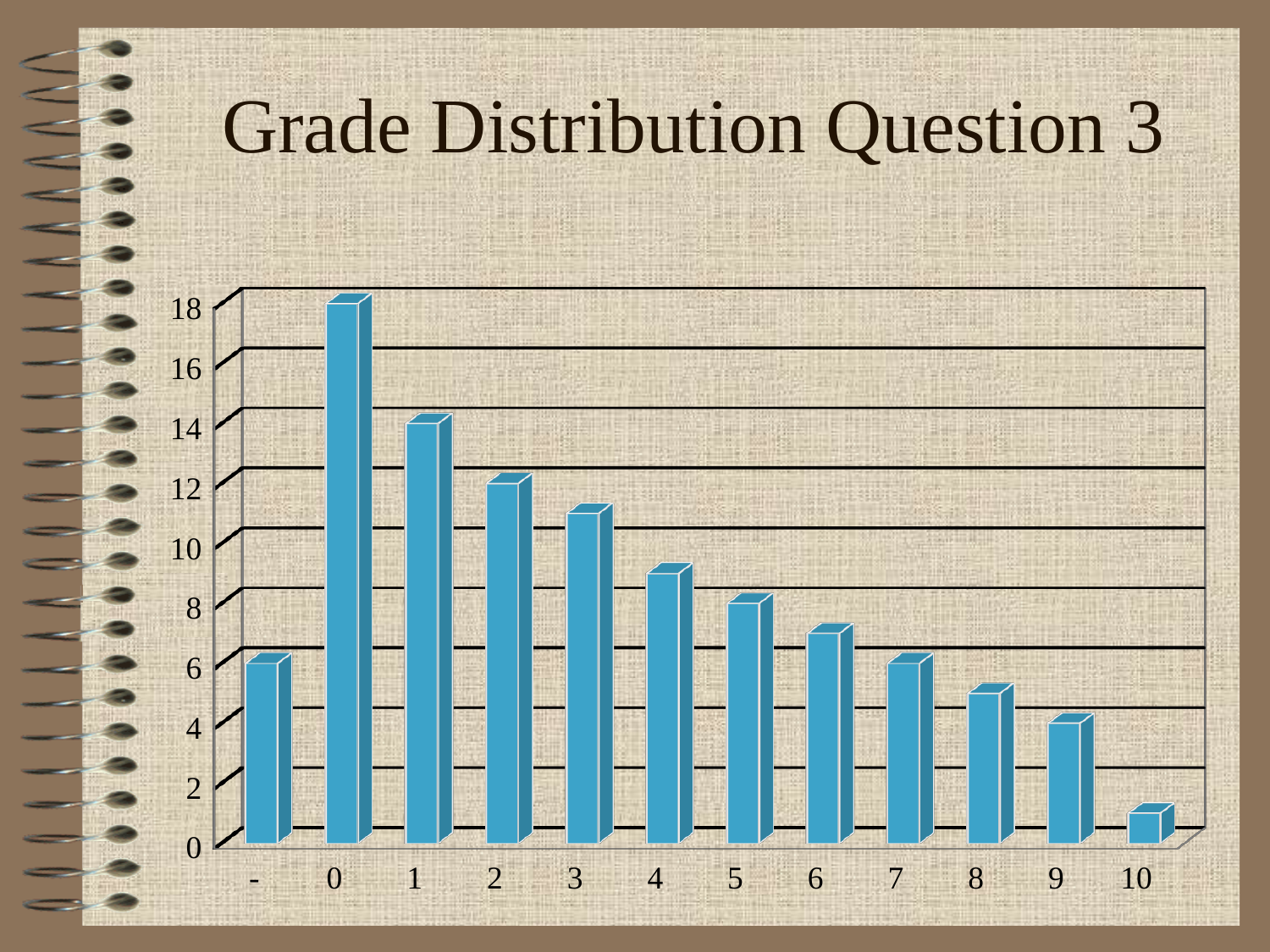
What is the value for category 1? 14 Which is larger, the value for category 1 or the value for category 5? category 1 Is the value for category 3 greater or less than 10? greater Do the values rise or fall along the x axis from category 0 to category 10? fall What is the value for category 0? 18 What kind of chart is shown on the slide? bar chart What is the value for category 2? 12 Which category has the highest bar? 0 What is the difference between the values for category 0 and category 1? 4 What is the title of the chart? Grade Distribution Question 3 Which category has the lowest bar? 10 How many categories are shown on the x axis? 12